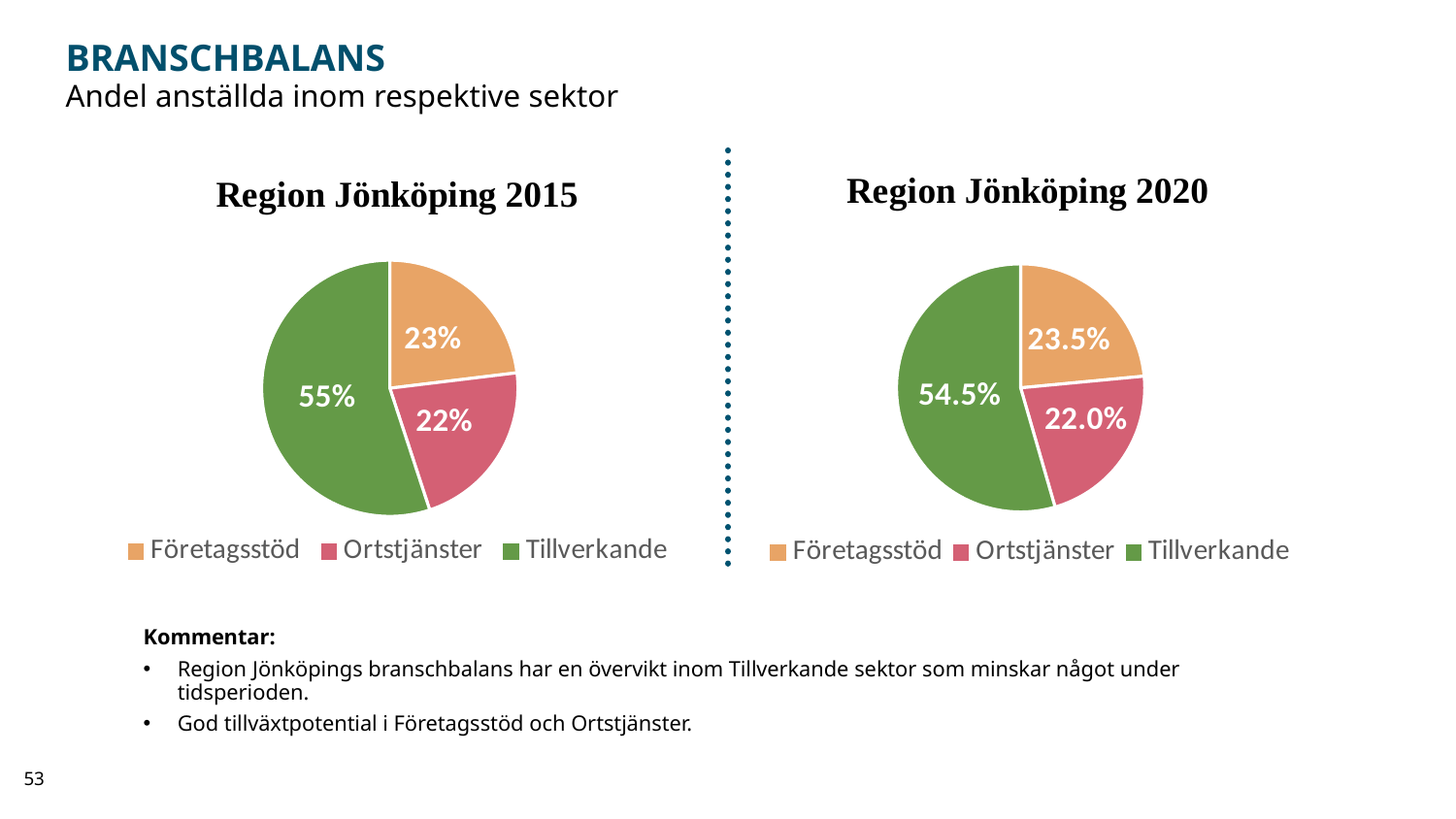
In the 'Region Jönköping 2015' chart, what is the difference between the Tillverkande share and the Ortstjänster share? 33 percentage points In the 'Region Jönköping 2020' chart, what colour is the Tillverkande slice? Green In the 'Region Jönköping 2015' chart, which sector has the largest share? Tillverkande In the 'Region Jönköping 2020' chart, what share does Ortstjänster have? 22.0% In the 'Region Jönköping 2020' chart, what share does Tillverkande have? 54.5% In the 'Region Jönköping 2020' chart, which sector has the smallest share? Ortstjänster What type of chart is 'Region Jönköping 2015'? Pie chart In the 'Region Jönköping 2020' chart, what is the difference between the Företagsstöd share and the Ortstjänster share? 1.5 percentage points In the 'Region Jönköping 2015' chart, what share does Företagsstöd have? 23% In the 'Region Jönköping 2015' chart, which is larger: the Företagsstöd share or the Ortstjänster share? Företagsstöd In the 'Region Jönköping 2015' chart, what share does Tillverkande have? 55% How many slices does the 'Region Jönköping 2020' chart have? 3